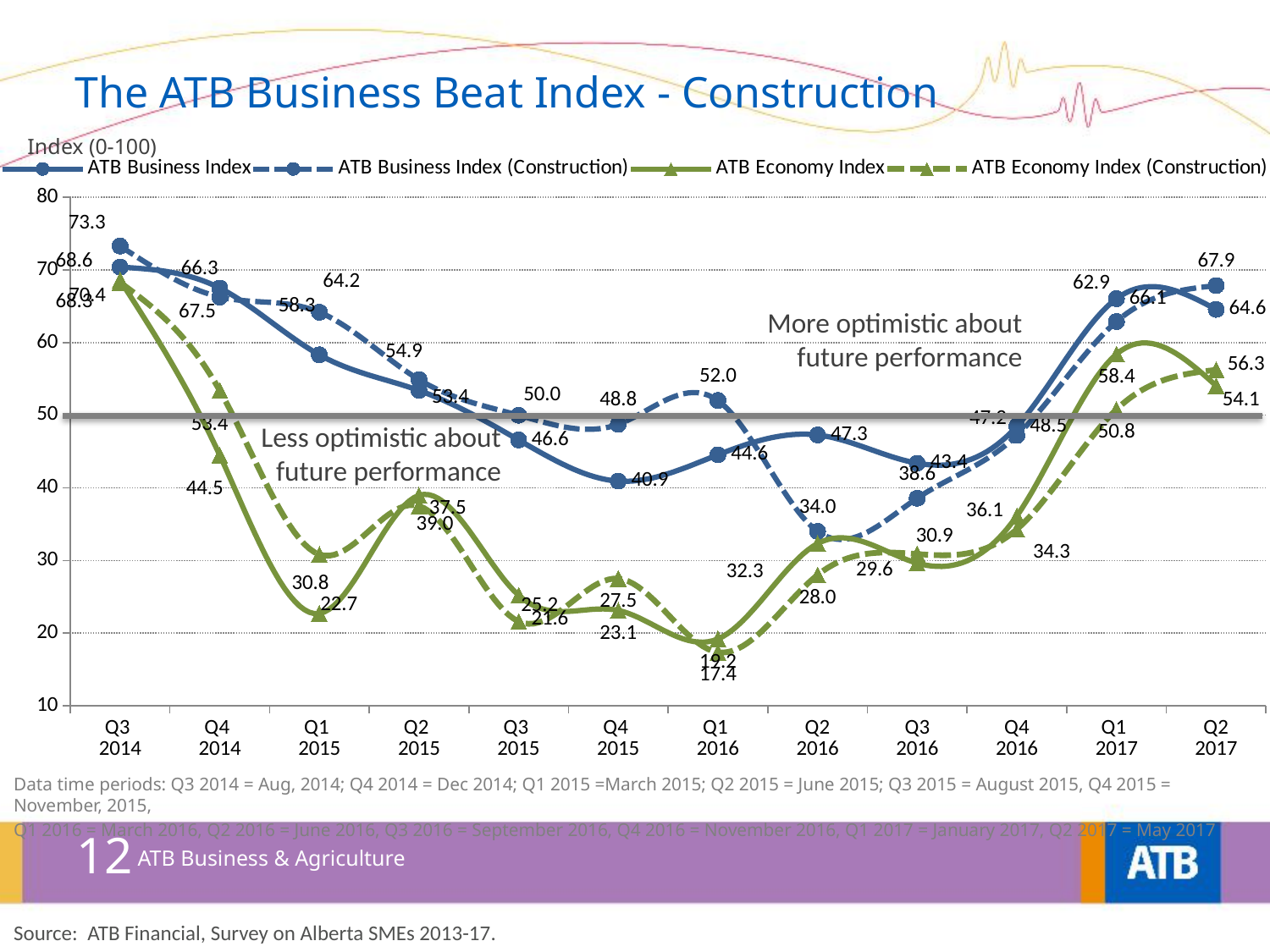
In which quarter does the ATB Economy Index (Construction) reach its lowest value? Q1 2016 In which quarter does the ATB Business Index (Construction) reach its highest value? Q3 2014 How many quarters are plotted along the x axis? 12 What is the value of the ATB Business Index (Construction) in Q1 2016? 52.0 In Q2 2017, which is higher: the ATB Business Index (Construction) or the ATB Economy Index (Construction)? ATB Business Index (Construction) What is the value of the ATB Business Index (Construction) in Q2 2016? 34.0 Is the value of the ATB Economy Index (Construction) in Q1 2015 greater or less than 40? less What is the value of the ATB Business Index (Construction) in Q2 2017? 67.9 What kind of chart is shown on the slide? Line chart By how much did the ATB Business Index (Construction) rise from Q2 2016 to Q2 2017? 33.9 Does the ATB Business Index (Construction) rise or fall from Q3 2014 to Q2 2016? Fall How many series does the legend list? 4